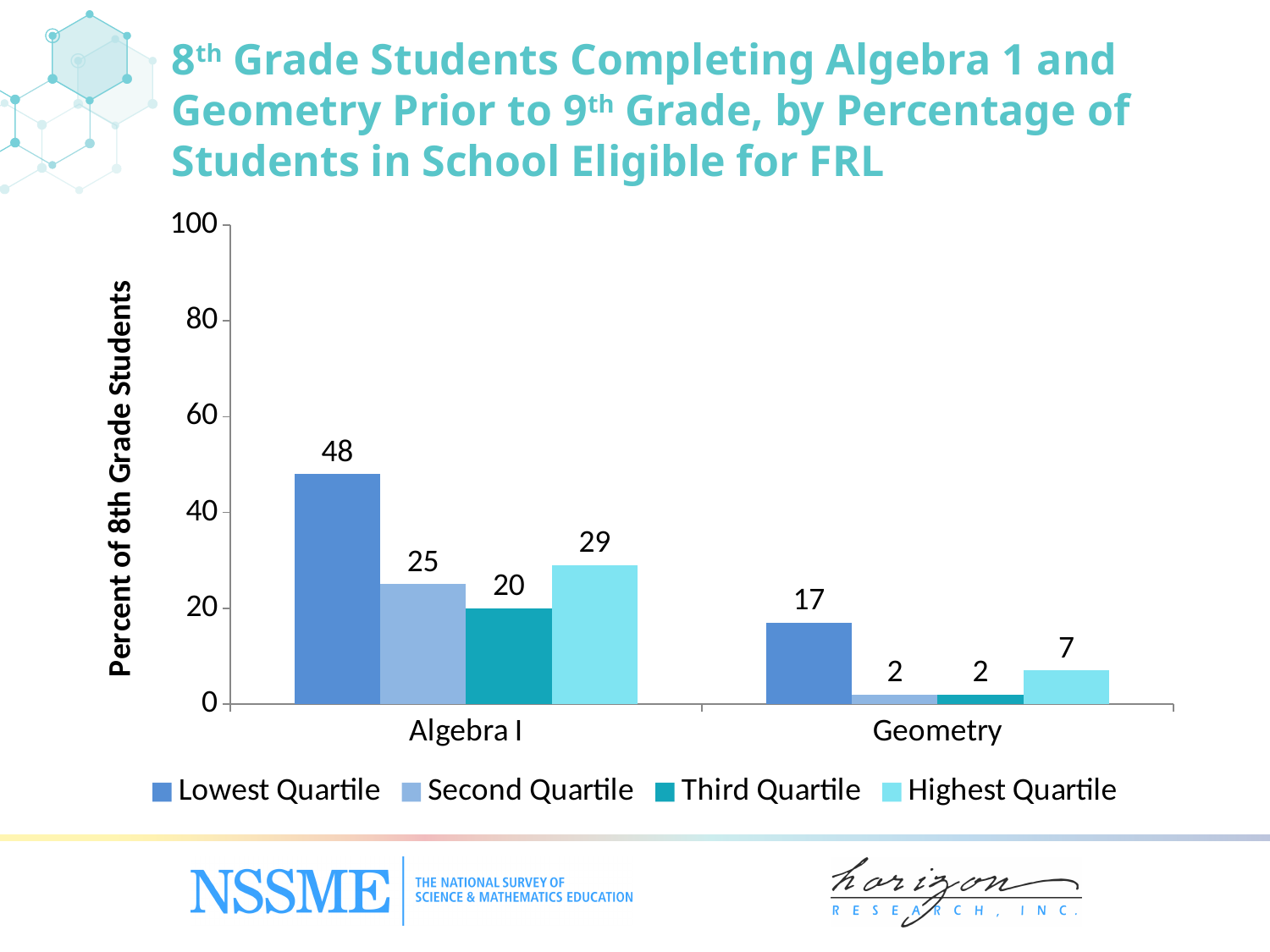
Which is larger for Geometry: the Lowest Quartile value or the Highest Quartile value? Lowest Quartile Is the value for Lowest Quartile schools for Algebra I greater or less than 40? greater What is the value for Highest Quartile schools for Geometry? 7 What is the label of the vertical axis? Percent of 8th Grade Students What kind of chart is shown on the slide? Bar chart What is the difference between the Lowest Quartile and Highest Quartile values for Algebra I? 19 What is the value for Third Quartile schools for Algebra I? 20 Which quartile has the highest value for Algebra I? Lowest Quartile How many series does the legend list? 4 What is the difference between the Lowest Quartile values for Algebra I and Geometry? 31 Which quartile has the lowest value for Algebra I? Third Quartile What percentage of 8th grade students in Lowest Quartile schools completed Algebra I? 48